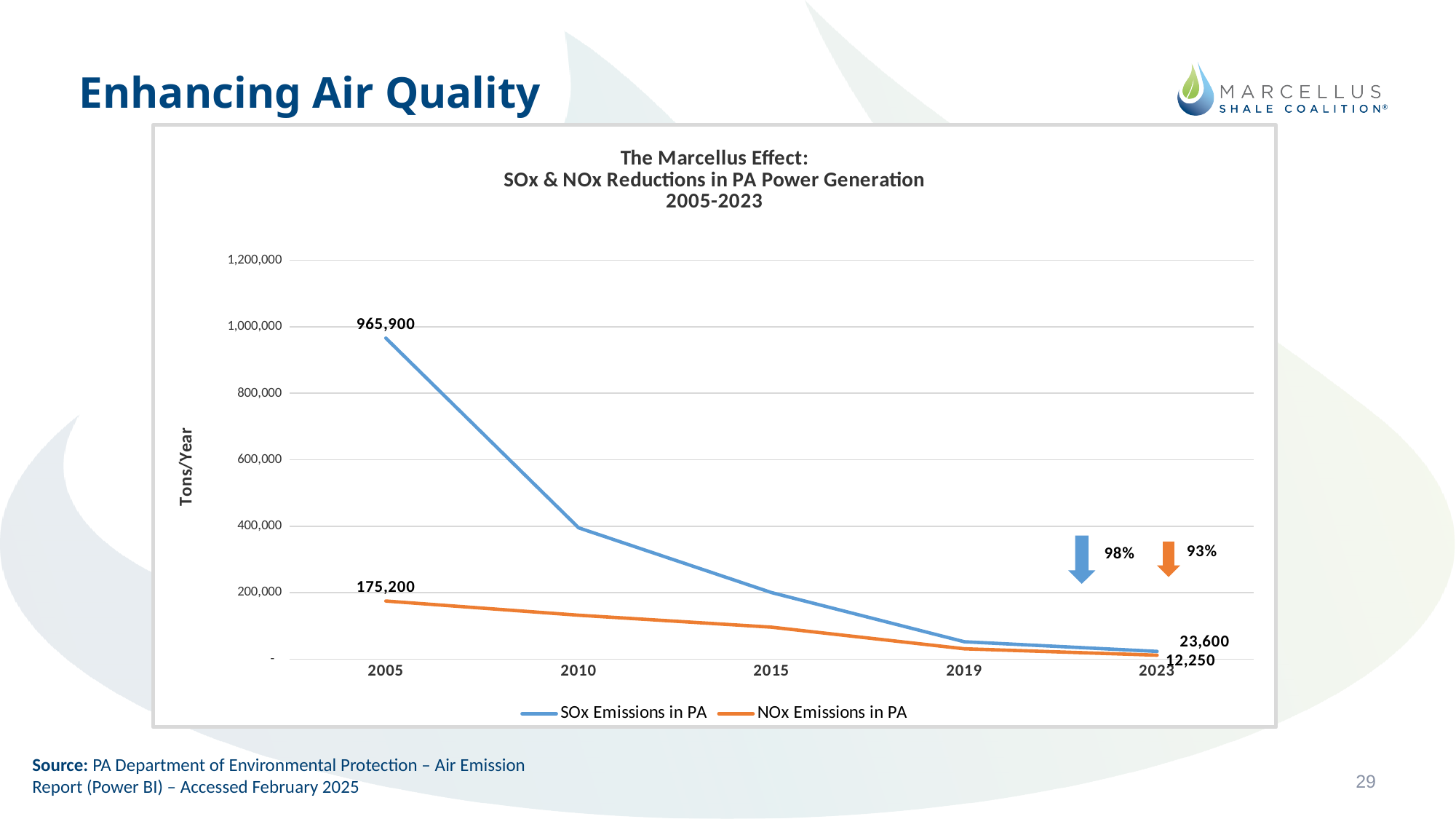
How many years are plotted on the x axis? 5 What is the value of SOx Emissions in PA in 2023? 23,600 What kind of chart is shown on the slide? line chart What is the value of NOx Emissions in PA in 2005? 175,200 Do SOx Emissions in PA rise or fall from 2005 to 2023? fall In 2005, which series had the higher value, SOx Emissions in PA or NOx Emissions in PA? SOx Emissions in PA By how much did SOx Emissions in PA fall between 2005 and 2023? 942,300 What is the value of NOx Emissions in PA in 2023? 12,250 By how much did NOx Emissions in PA fall between 2005 and 2023? 162,950 How many series does the legend list? 2 Is the value for SOx Emissions in PA in 2010 greater or less than 600,000? less What is the value of SOx Emissions in PA in 2005? 965,900